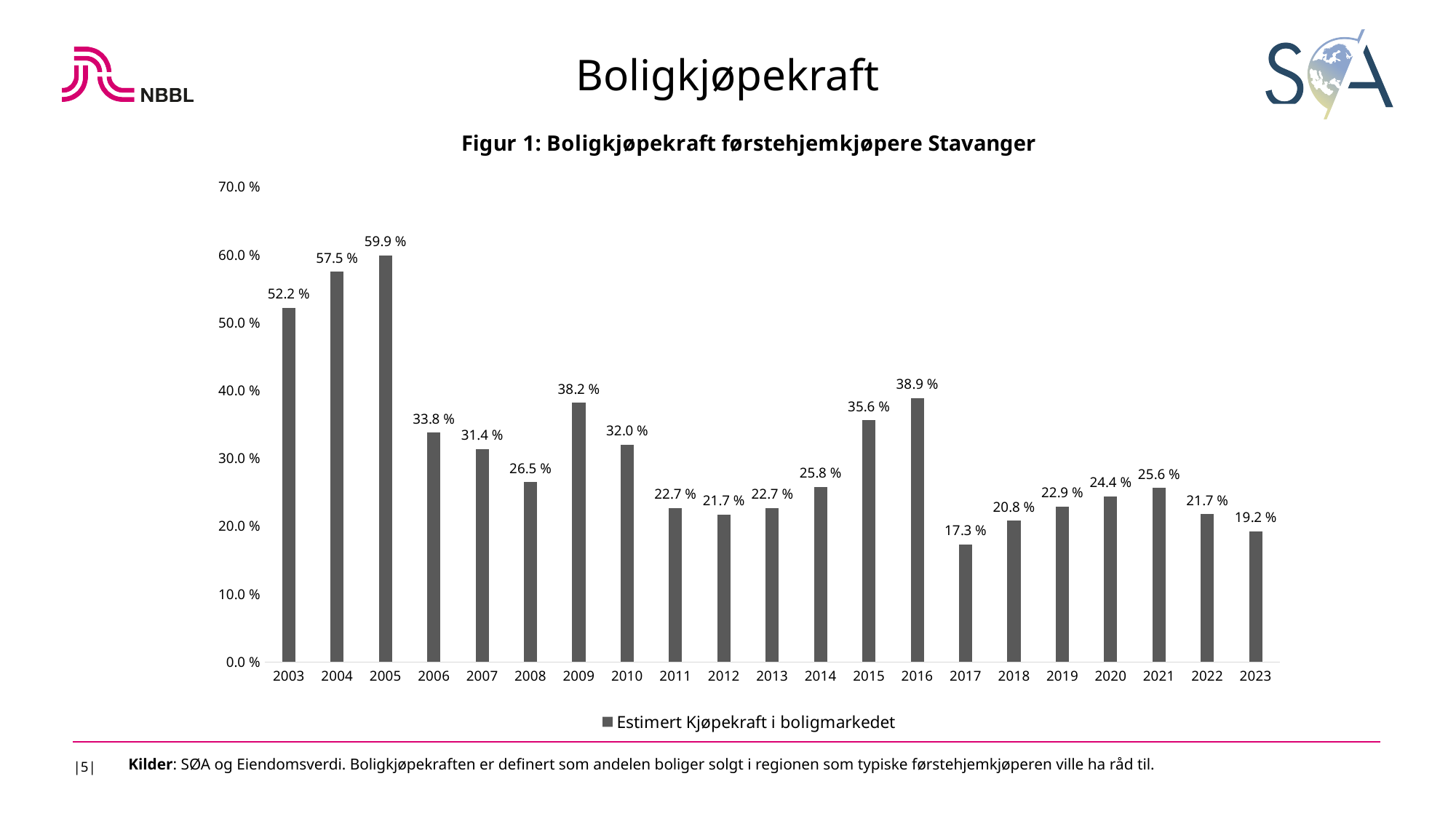
Which is larger, the value for 2009 or the value for 2016? 2016 Is the value for 2015 greater or less than 30.0 %? greater Which year has the highest value? 2005 What is the value for 2023? 19.2 % What kind of chart is shown? bar chart How many series does the legend list? 1 What is the value for 2005? 59.9 % Which year has the lowest value? 2017 What is the legend entry for the series? Estimert Kjøpekraft i boligmarkedet What is the value for 2017? 17.3 % How many years are shown on the x axis? 21 What is the difference between the values for 2003 and 2023? 33.0 %